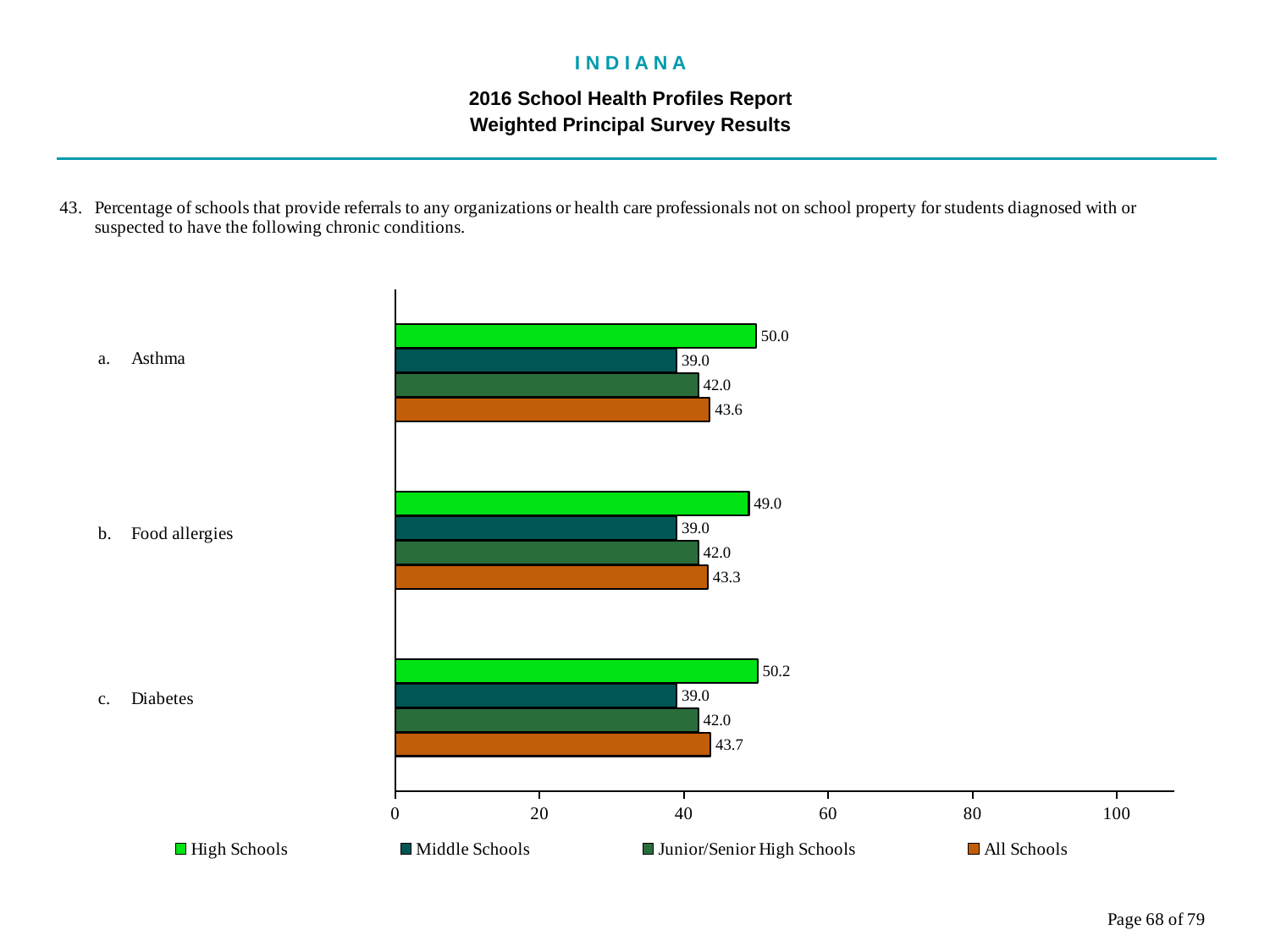
How many series does the legend list? 4 How many chronic conditions are shown on the chart? 3 What is the value for All Schools for Food allergies? 43.3 What is the value for High Schools for Asthma? 50.0 What is the value for Middle Schools for Diabetes? 39.0 What is the difference between the High Schools and Middle Schools values for Asthma? 11.0 What kind of chart is shown on the slide? Bar chart What is the value for Junior/Senior High Schools for Food allergies? 42.0 Which is larger for Food allergies: the High Schools value or the All Schools value? High Schools Which series is shown in orange in the legend? All Schools Which school type has the lowest value for Asthma? Middle Schools Which school type has the highest value for Diabetes? High Schools